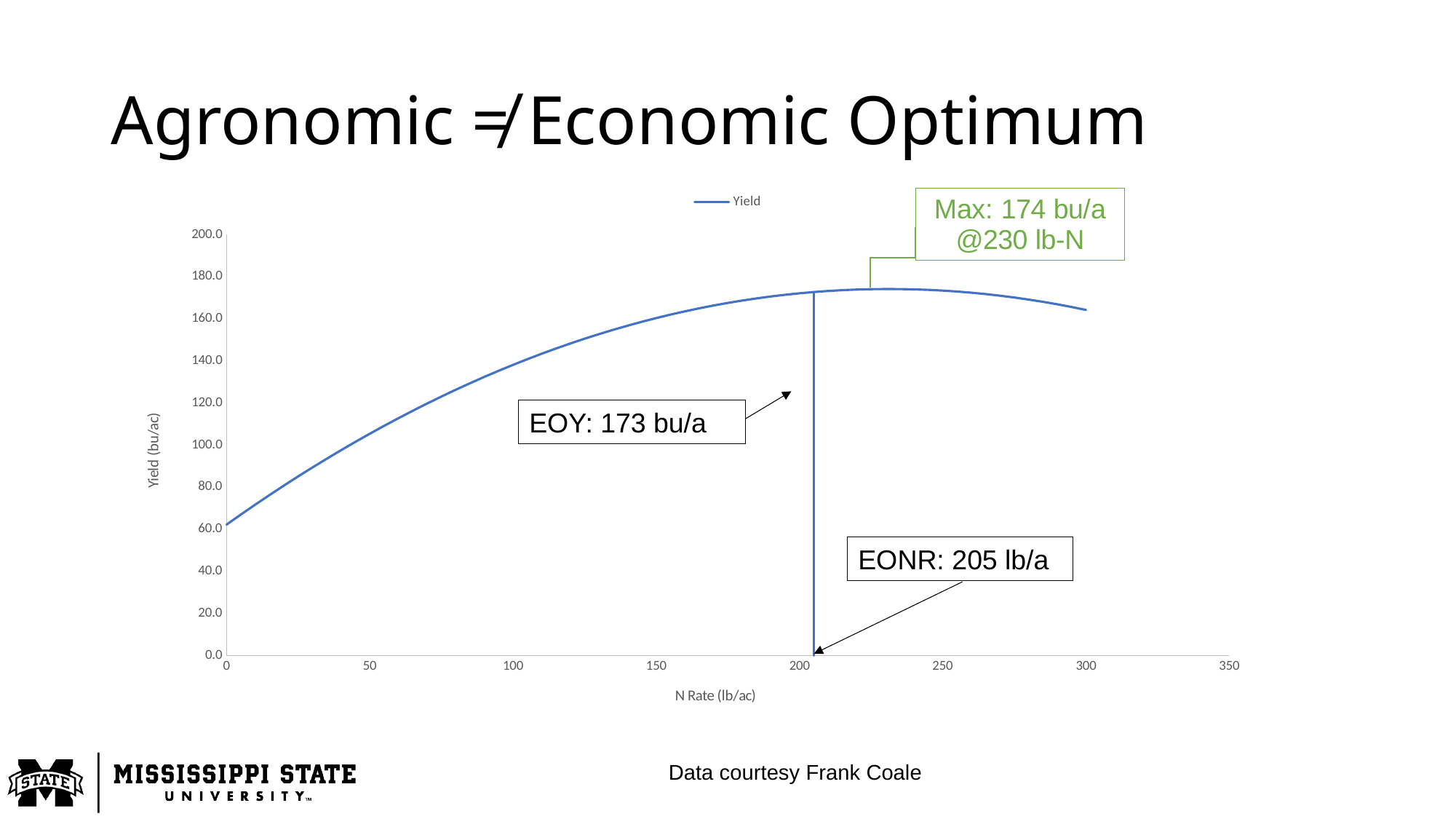
How many series does the chart legend list? 1 What is the EOY value labelled on the chart? 173 bu/a What kind of chart is shown on the slide? line chart Is the yield at an N rate of 300 greater or less than 140.0? greater What is the name of the series shown in the chart legend? Yield Is the yield at an N rate of 0 greater or less than 80.0? less Does the yield rise or fall as the N rate increases from 0 to 200? rise What is the EONR value labelled on the chart? 205 lb/a What is the difference between the maximum yield and the EOY labelled on the chart? 1 bu/a What is the title of the x axis of the chart? N Rate (lb/ac) According to the annotation, what is the maximum yield shown on the chart? 174 bu/a At what N rate does the annotation say the maximum yield occurs? 230 lb-N